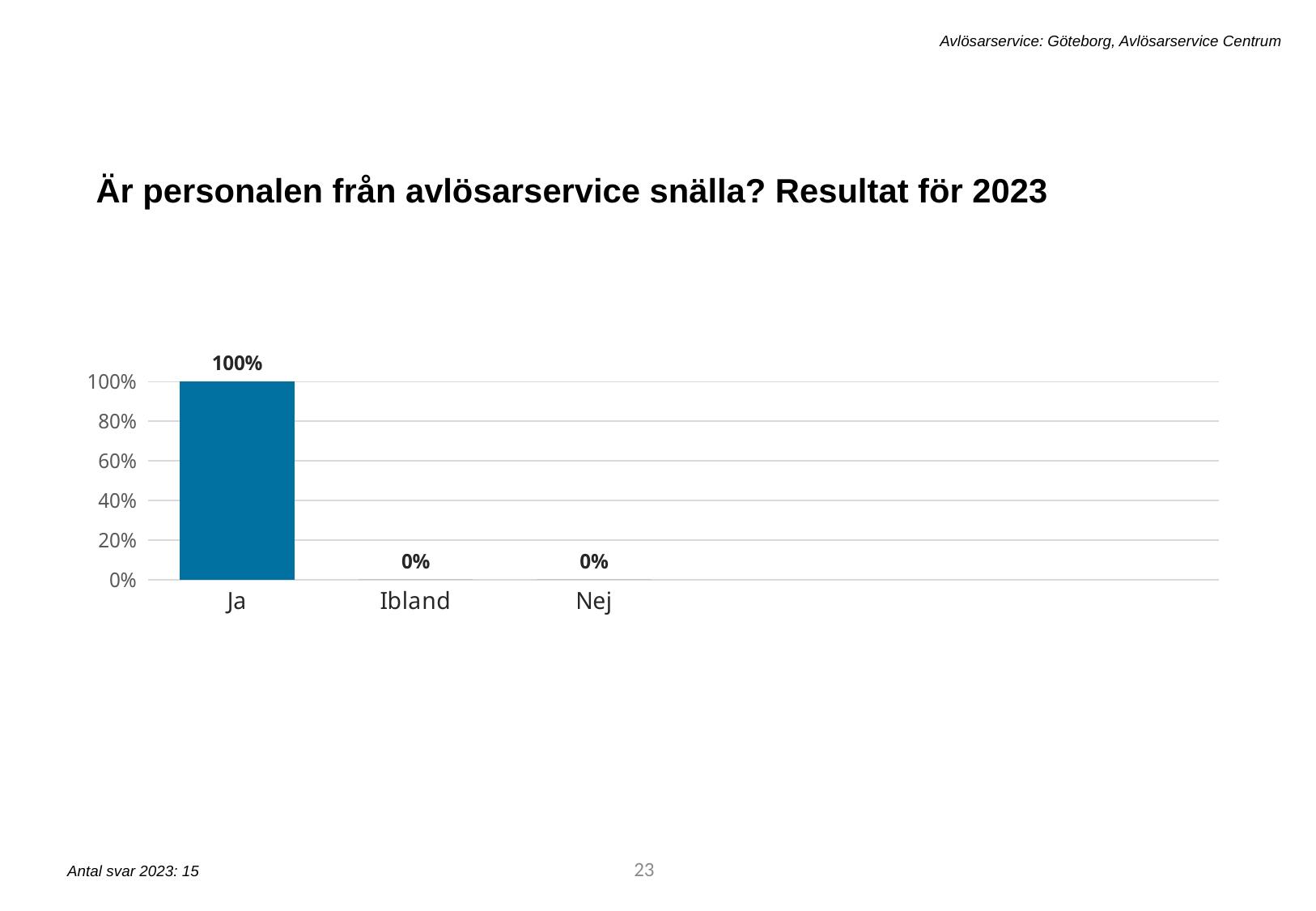
What is the title of the chart? Är personalen från avlösarservice snälla? Resultat för 2023 Which category has the highest value? Ja What is the value for Ja? 100% What is the difference between the values for Ja and Nej? 100% Which is larger, the value for Ja or the value for Ibland? Ja What is the value for Nej? 0% What is the value for Ibland? 0% How many categories are shown on the x axis? 3 Is the value for Ja greater or less than 80%? greater What is the highest tick value shown on the y axis? 100% What kind of chart is shown on the slide? bar chart